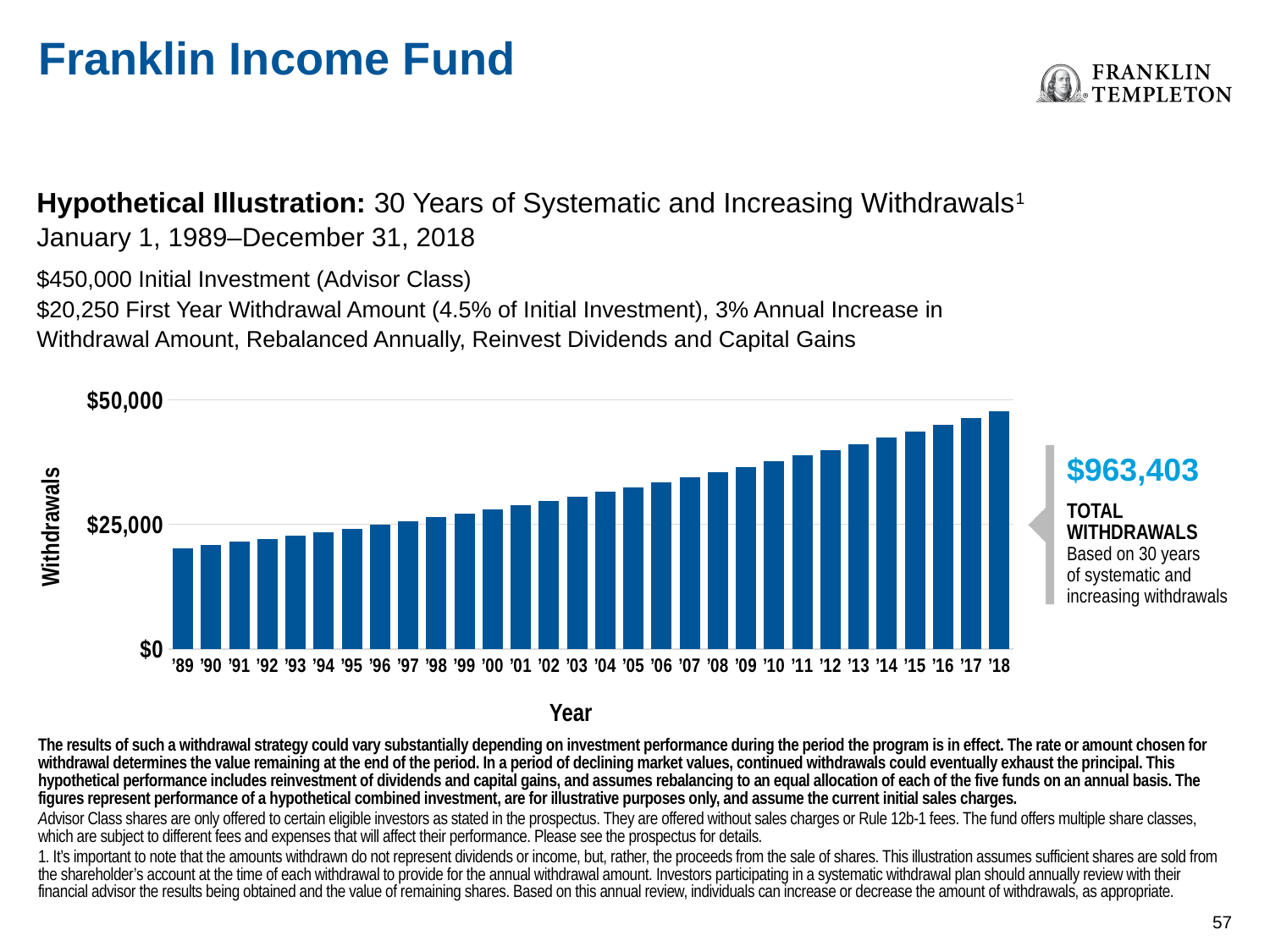
Is the withdrawal value for '10 greater or less than $25,000? greater What total withdrawals figure is shown in the callout next to the chart? $963,403 How many years (bars) are plotted in the chart? 30 Which year has the lowest withdrawal amount in the chart? '89 Do the withdrawal amounts rise or fall from '89 to '18? Rise Which year has the highest withdrawal amount in the chart? '18 Is the withdrawal value for '18 greater or less than $50,000? less What kind of chart is shown on the slide? Bar chart Is the withdrawal value for '89 greater or less than $25,000? less What is the label on the vertical axis of the chart? Withdrawals Which year has the larger withdrawal amount, '05 or '15? '15